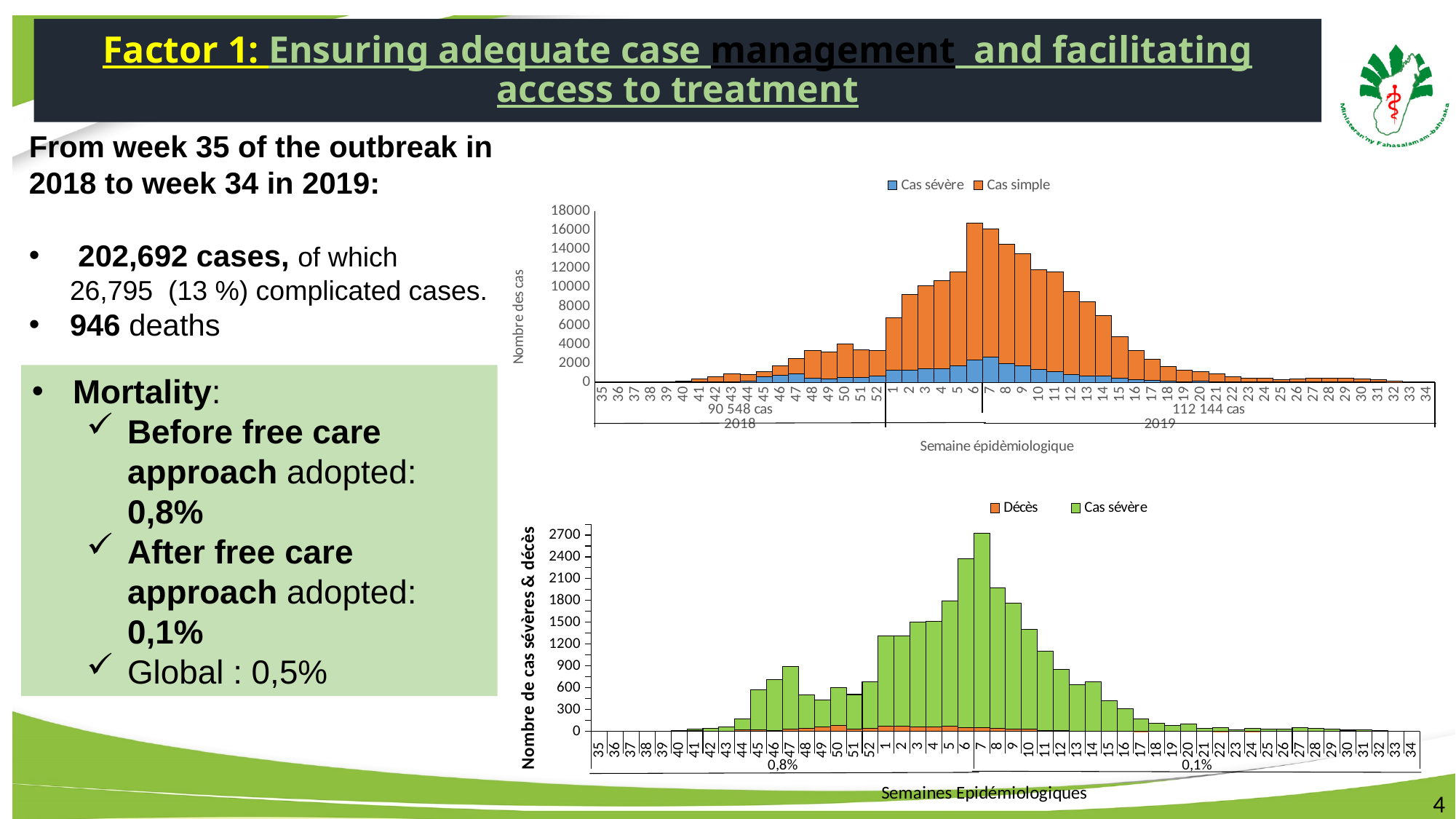
What kind of chart is the top chart on the slide? bar chart In the bottom chart, which epidemiological week has the highest number of severe cases? 7 In the bottom chart, do the severe cases rise or fall from week 1 to week 7? rise What is the y-axis label of the top chart? Nombre des cas In the bottom chart, is the value for week 47 greater or less than 600? greater What are the two legend entries of the bottom chart? Décès and Cas sévère In the bottom chart, is the value for week 7 greater or less than 2400? greater How many epidemiological weeks are shown on the x axis of the bottom chart? 52 In the top chart, do the total cases rise or fall from week 7 to week 34? fall How many series does the legend of the top chart list? 2 In the top chart, is the total number of cases for week 1 greater or less than 8000? less